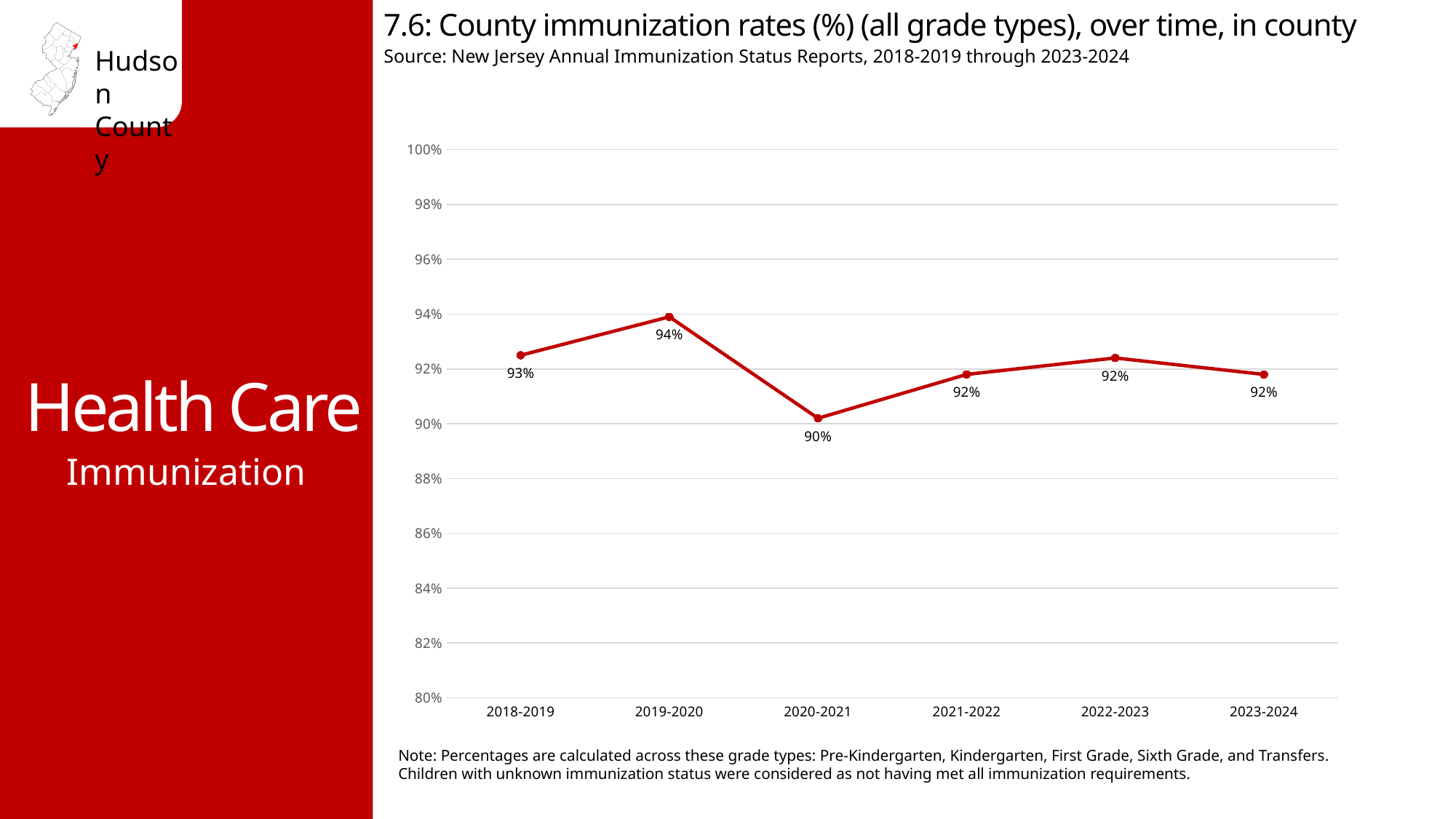
Which school year has the highest immunization rate? 2019-2020 What is the county immunization rate for 2019-2020? 94% What is the difference between the immunization rate in 2019-2020 and in 2020-2021? 4 percentage points Which school year has the lowest immunization rate? 2020-2021 Which is larger, the immunization rate in 2018-2019 or in 2020-2021? 2018-2019 Is the immunization rate for 2020-2021 greater or less than 92%? less What kind of chart is shown on the slide? Line chart What is the county immunization rate for 2023-2024? 92% Did the immunization rate rise or fall from 2019-2020 to 2020-2021? Fall What is the county immunization rate for 2020-2021? 90% What is the county immunization rate for 2018-2019? 93% How many school years are plotted on the chart? 6